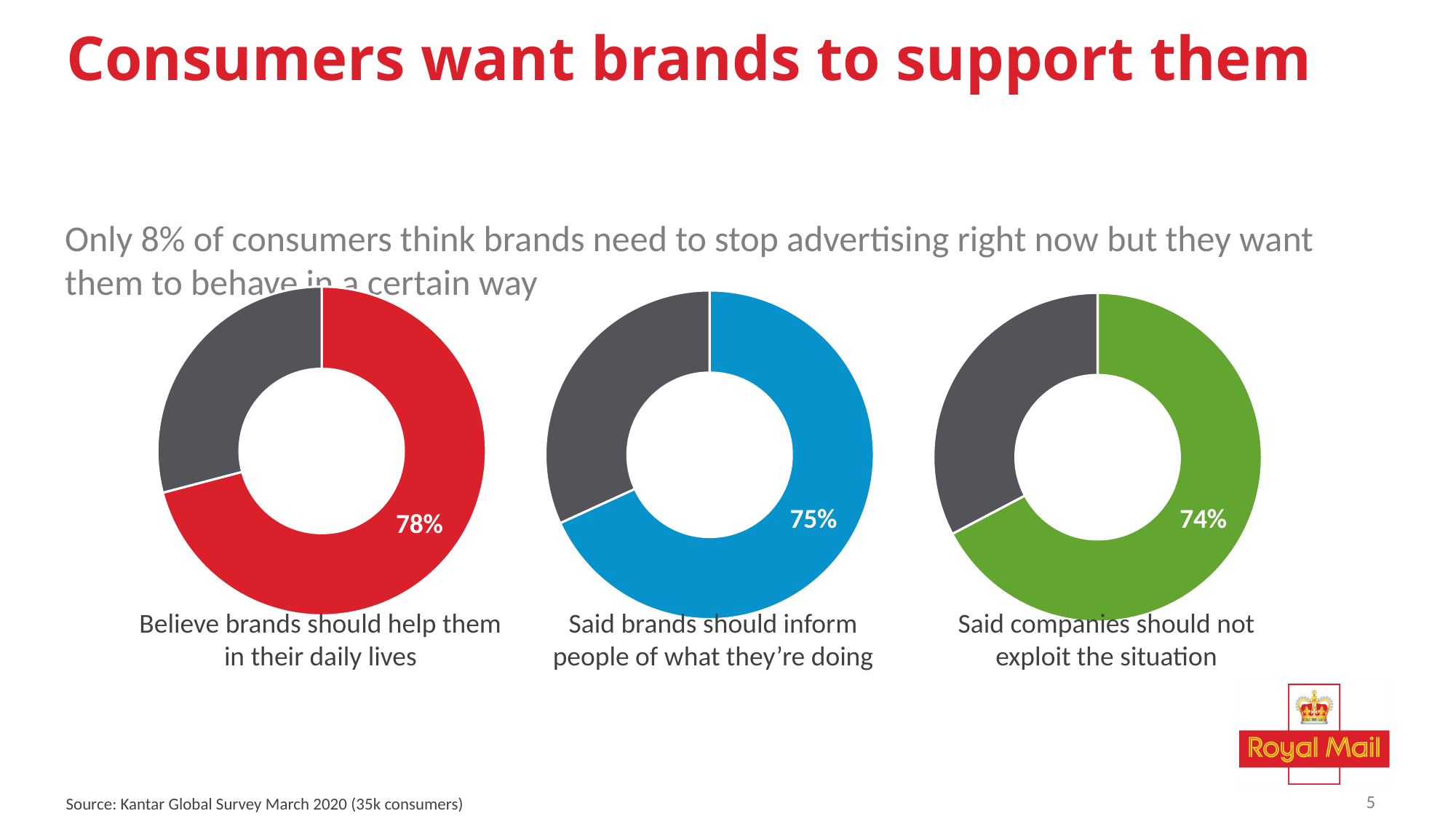
How many donut charts are shown on the slide? 3 Which of the three donut charts shows the lowest percentage? Said companies should not exploit the situation What colour is the highlighted segment of the middle donut chart? Blue What is the difference between the percentage on the middle donut chart and the percentage on the right donut chart? 1 percentage point What percentage is shown on the right donut chart, labelled 'Said companies should not exploit the situation'? 74% Which of the three donut charts shows the highest percentage? Believe brands should help them in their daily lives Which is larger: the percentage on the left donut chart or the percentage on the middle donut chart? The left donut chart (78%) What percentage is shown on the left donut chart, labelled 'Believe brands should help them in their daily lives'? 78% What colour is the highlighted segment of the right donut chart? Green What type of chart is used to show the three percentages on the slide? Donut (pie) chart What percentage is shown on the middle donut chart, labelled 'Said brands should inform people of what they're doing'? 75% What is the difference between the percentage on the left donut chart (78%) and the percentage on the right donut chart (74%)? 4 percentage points